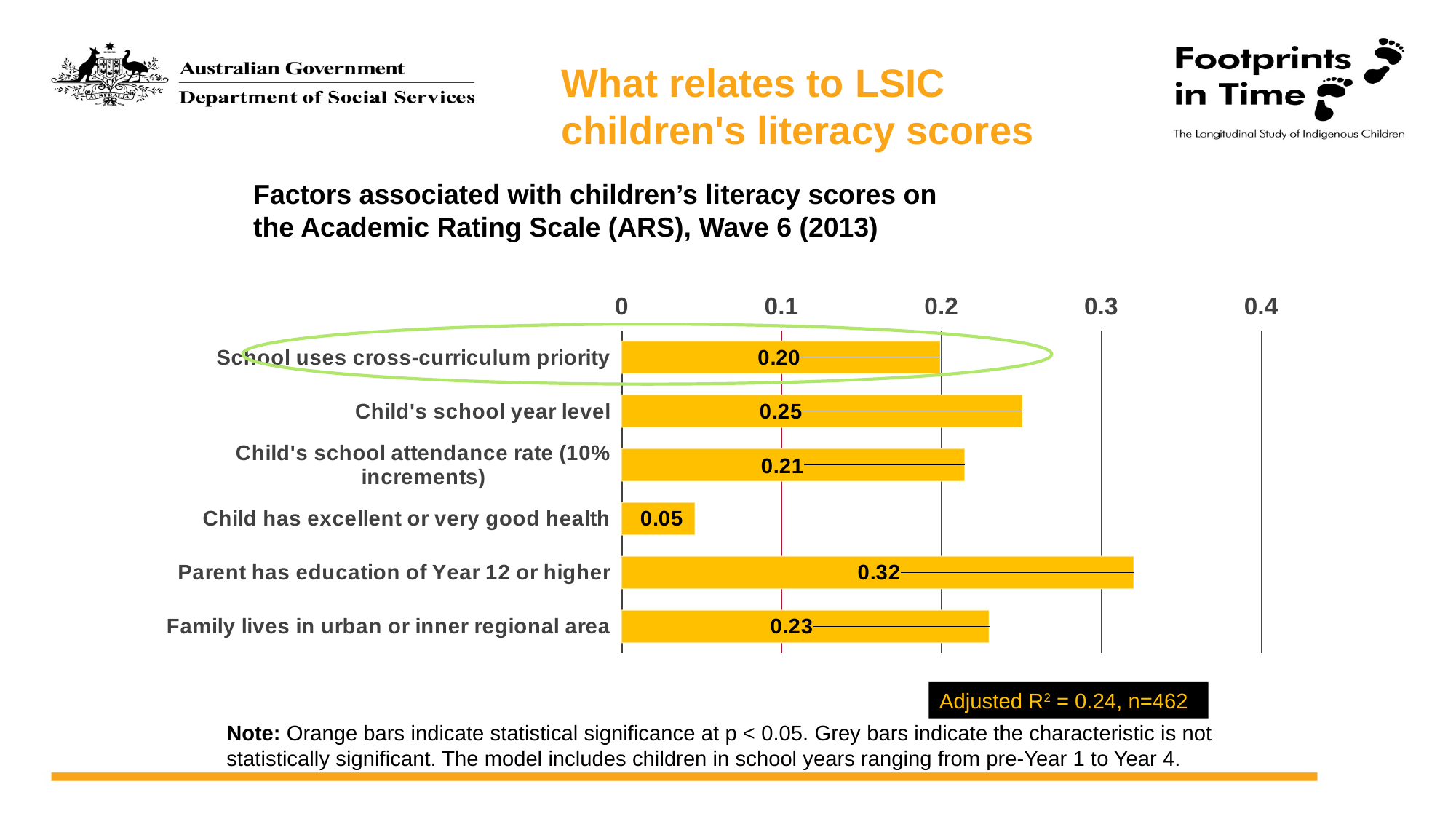
What is the value for "Parent has education of Year 12 or higher"? 0.32 What is the value for "Family lives in urban or inner regional area"? 0.23 Is the value for "Child's school attendance rate (10% increments)" greater or less than 0.3? less What kind of chart is shown on the slide? bar chart Which factor has the highest value? Parent has education of Year 12 or higher What is the adjusted R² reported for the model? 0.24 How many factors are plotted in the chart? 6 What is the value for "School uses cross-curriculum priority"? 0.20 What is the difference between the values for "Child's school year level" and "School uses cross-curriculum priority"? 0.05 What is the value for "Child has excellent or very good health"? 0.05 Which factor has the lowest value? Child has excellent or very good health Which is larger: the value for "Child's school year level" or the value for "Family lives in urban or inner regional area"? Child's school year level